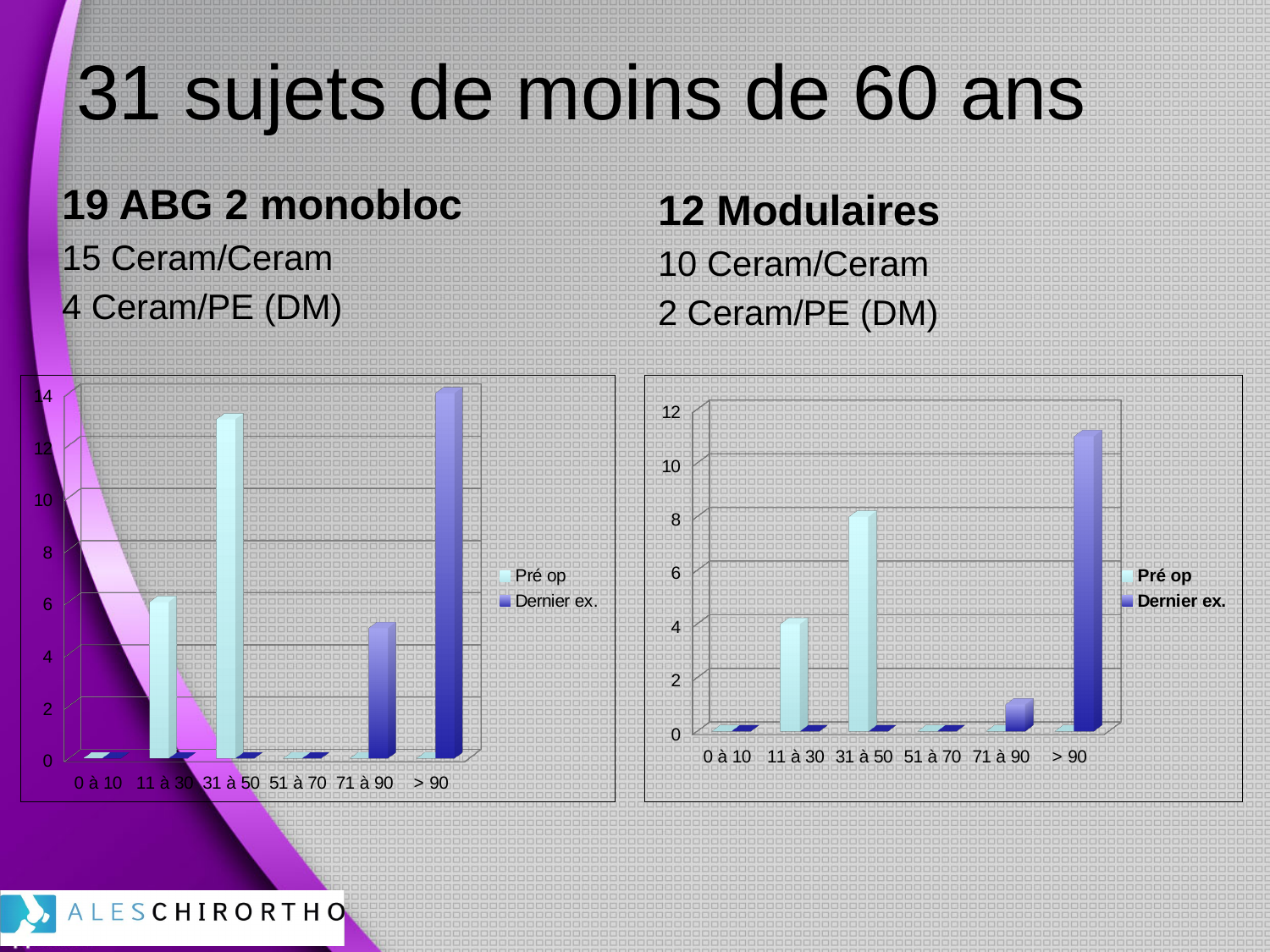
In the left chart, which category has the highest Dernier ex. value? > 90 In the left chart, is the Pré op value for 31 à 50 greater or less than 12? greater In the right chart, is the Pré op value for 11 à 30 greater or less than 6? less In the right chart, which is larger for the 71 à 90 category, the Pré op value or the Dernier ex. value? Dernier ex. How many series does the legend of the right chart list? 2 In the left chart, which category has the highest Pré op value? 31 à 50 What are the two legend entries of the left chart? Pré op and Dernier ex. In the right chart, which category has the highest Pré op value? 31 à 50 How many categories are shown on the x axis of the left chart? 6 What kind of chart is the left chart on the slide? bar chart In the left chart, is the Dernier ex. value for 71 à 90 greater or less than 8? less